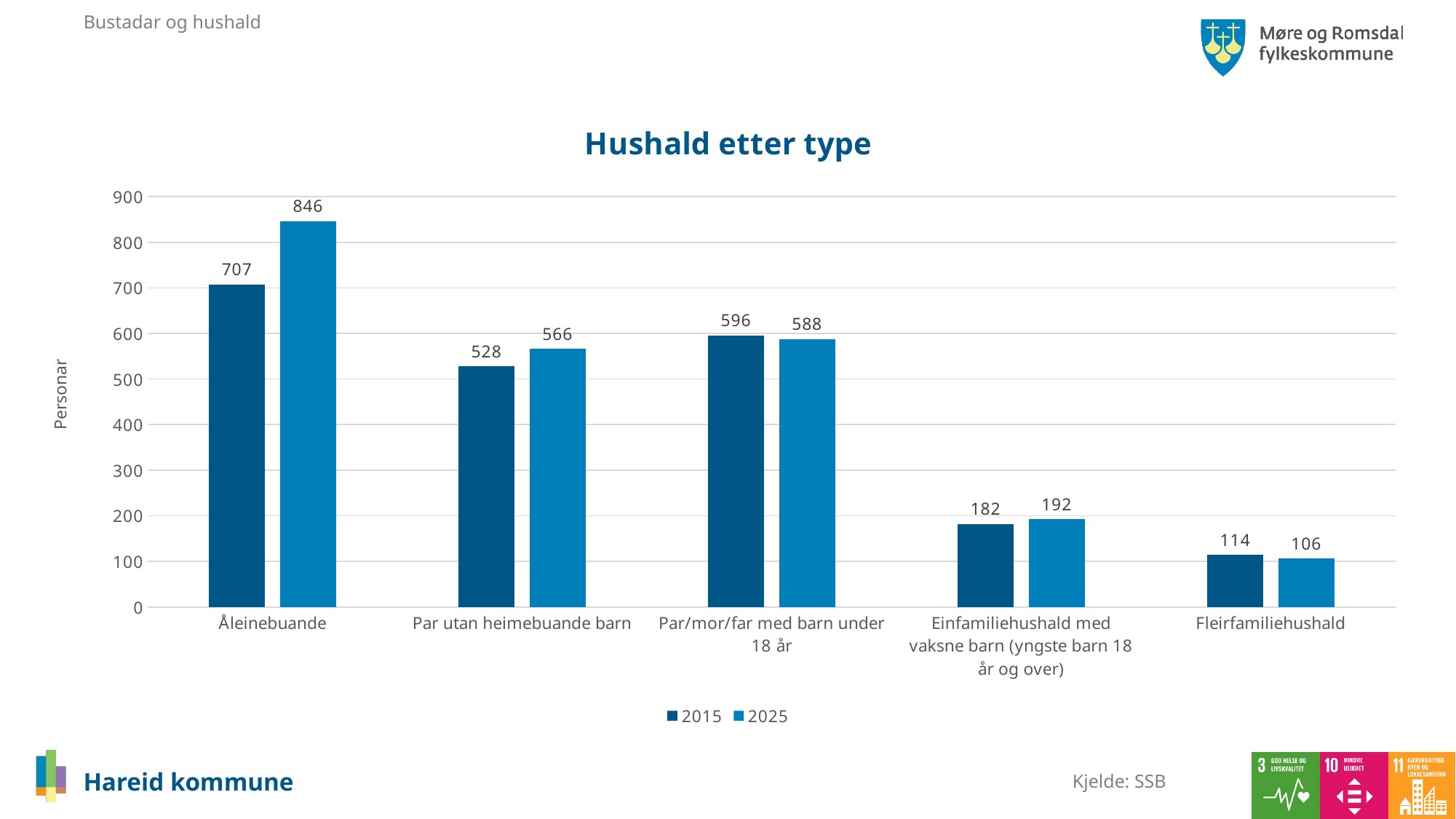
How many household categories are shown on the x axis? 5 What kind of chart is shown on the slide? Bar chart How many series does the legend list? 2 What is the value for Par utan heimebuande barn in 2015? 528 What is the difference between the 2025 and 2015 values for Åleinebuande? 139 What is the difference between the 2015 and 2025 values for Par/mor/far med barn under 18 år? 8 Which is larger for Einfamiliehushald med vaksne barn (yngste barn 18 år og over): the 2015 value or the 2025 value? 2025 Which category has the lowest value in 2015? Fleirfamiliehushald What is the value for Fleirfamiliehushald in 2025? 106 What is the value for Åleinebuande in 2025? 846 Which category has the highest value in 2025? Åleinebuande What is the title of the chart? Hushald etter type